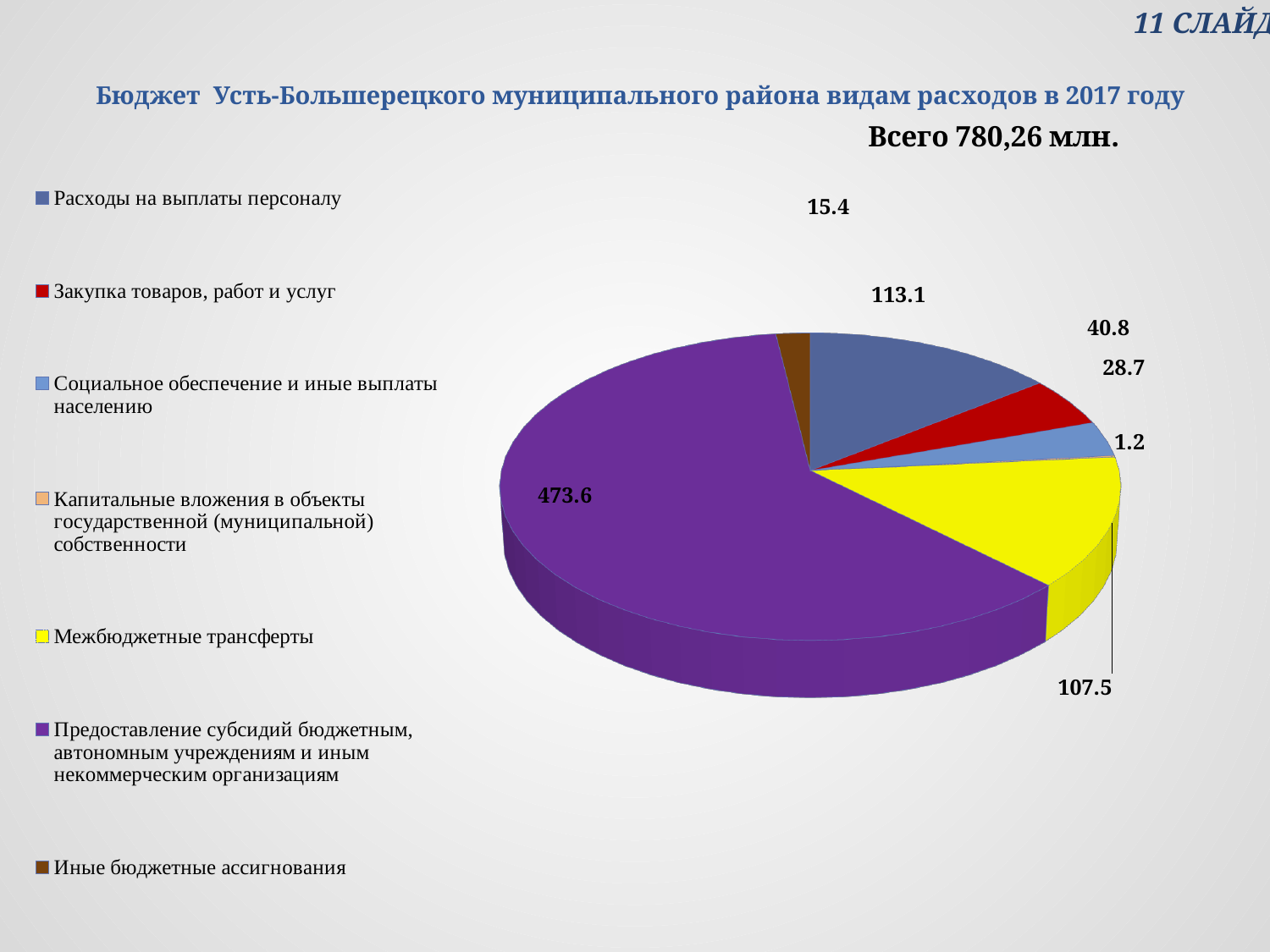
What is the value for Закупка товаров, работ и услуг? 40.8 Which is larger: Закупка товаров, работ и услуг or Социальное обеспечение и иные выплаты населению? Закупка товаров, работ и услуг What is the value for Межбюджетные трансферты? 107.5 What is the value for Расходы на выплаты персоналу? 113.1 Which category has the smallest slice of the pie? Капитальные вложения в объекты государственной (муниципальной) собственности What total amount is stated on the slide for the budget? 780,26 млн. Which category has the largest slice of the pie? Предоставление субсидий бюджетным, автономным учреждениям и иным некоммерческим организациям How many categories does the pie chart have? 7 What is the value for Иные бюджетные ассигнования? 15.4 What is the value for Предоставление субсидий бюджетным, автономным учреждениям и иным некоммерческим организациям? 473.6 What type of chart is shown on the slide? Pie chart What is the difference between the values for Расходы на выплаты персоналу and Межбюджетные трансферты? 5.6